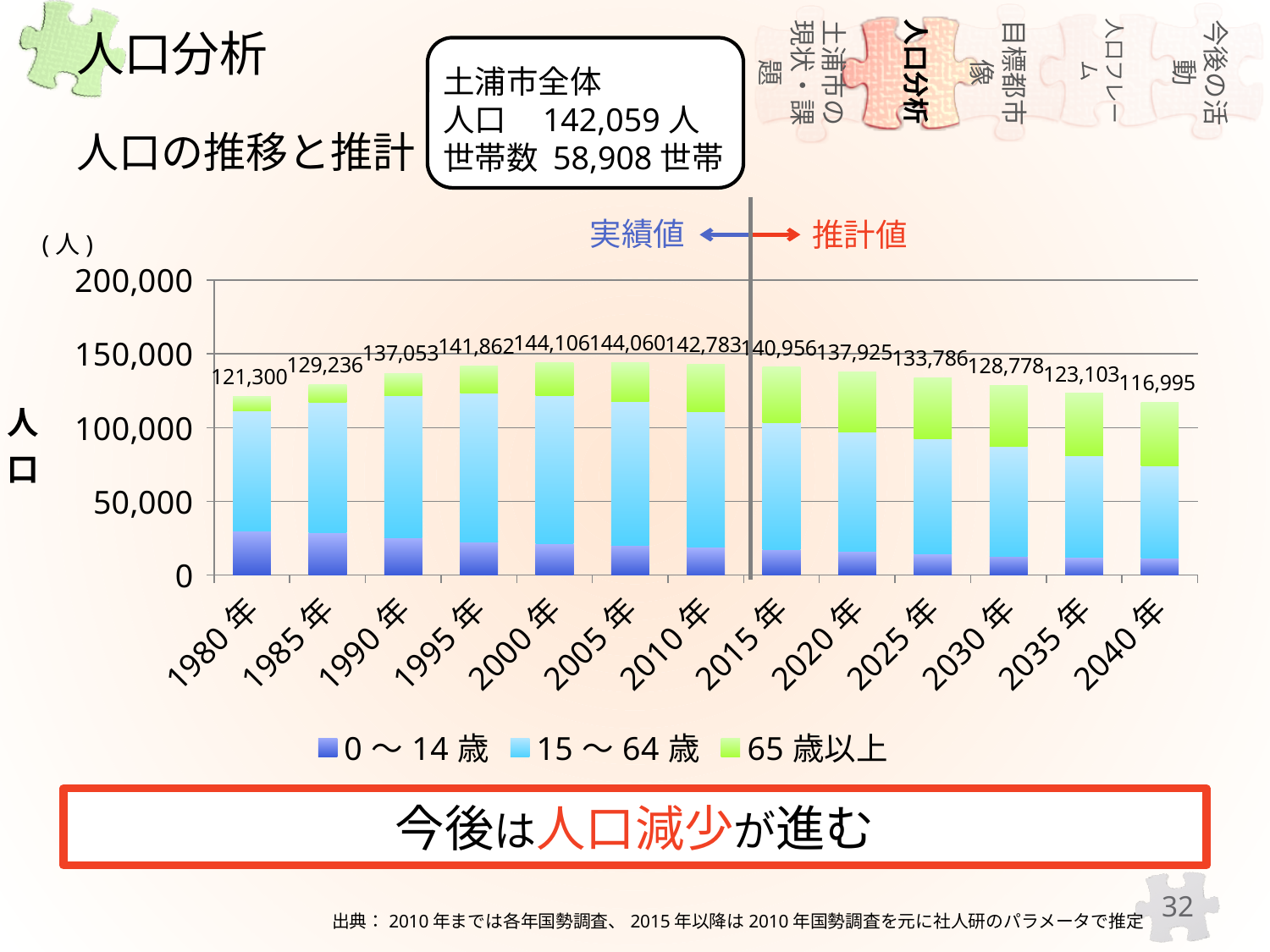
How many series does the legend list? 3 Which is larger, the total population in 1990年 or in 2030年? 1990年 What is the difference between the total population in 2010年 and in 2040年? 25,788 Do the total population values rise or fall from 2010年 to 2040年? fall What is the total population shown for 2040年? 116,995 Is the value of the 0～14歳 segment in 1980年 greater or less than 50,000? less What is the total population shown for 1980年? 121,300 How many years (categories) are shown on the x axis? 13 What is the total population shown for 2010年? 142,783 Which year has the highest total population in the chart? 2000年 Which year has the lowest total population in the chart? 2040年 What type of chart is shown on the slide? Stacked bar chart